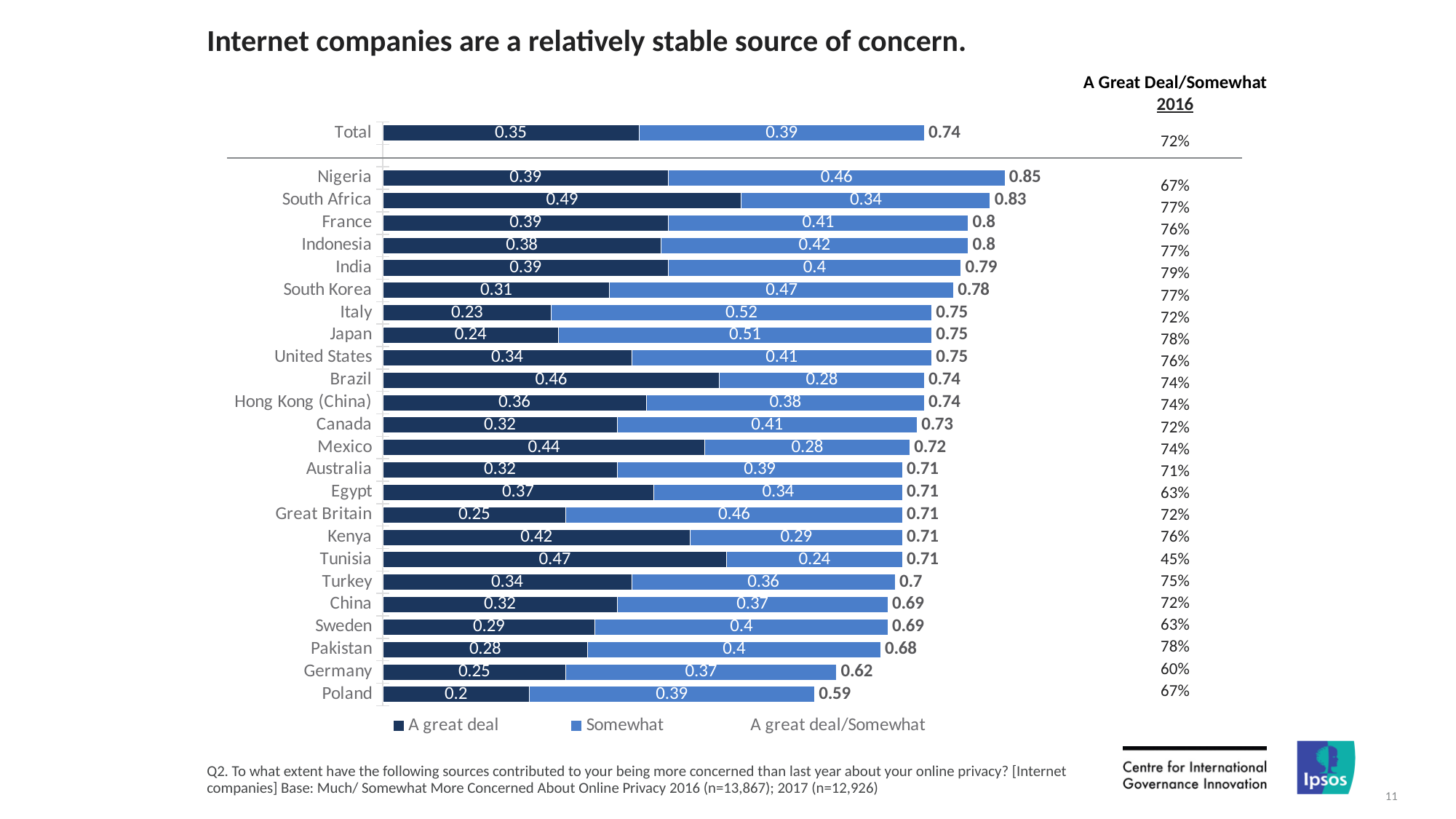
What is the 2016 'A Great Deal/Somewhat' percentage shown for Tunisia? 45% What is the 'A great deal/Somewhat' total for Nigeria? 0.85 What is the 'Somewhat' value for Italy? 0.52 What is the title of the slide? Internet companies are a relatively stable source of concern. How many series does the legend list? 3 What is the 'A great deal' value for South Africa? 0.49 Which country has the highest 'A great deal/Somewhat' total? Nigeria Which country has the lowest 'A great deal/Somewhat' total? Poland What is the difference between the 'A great deal' values for Brazil and Poland? 0.26 What is the 'A great deal/Somewhat' total for the Total row? 0.74 Which has a larger 'Somewhat' value, Japan or Mexico? Japan What kind of chart is shown on the slide? Stacked bar chart